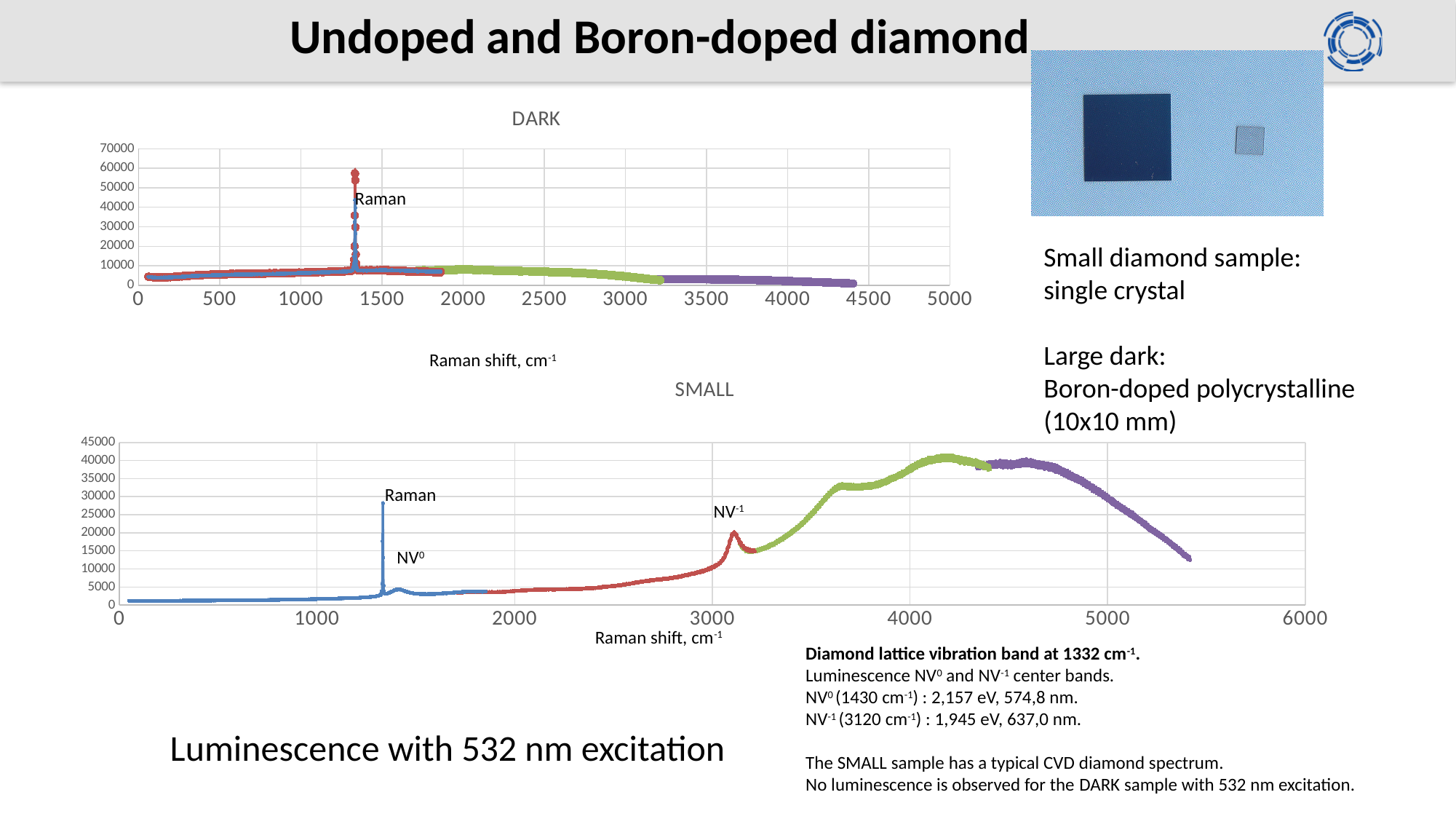
Which chart shows the higher Raman peak, DARK or SMALL? DARK In the SMALL chart, which peak is higher, the Raman peak or the NV-1 peak? Raman In the SMALL chart, is the height of the Raman peak greater or less than 20000? greater In the SMALL chart, is the height of the NV0 peak greater or less than 10000? less In the SMALL chart, is the maximum of the broad band around 4200 cm-1 greater or less than 35000? greater What is the x-axis label of the SMALL chart? Raman shift, cm-1 In the SMALL chart, do the values rise or fall as the Raman shift increases from 4600 to 5400? fall What is the title of the top chart on the slide? DARK What kind of chart is the DARK chart? scatter chart